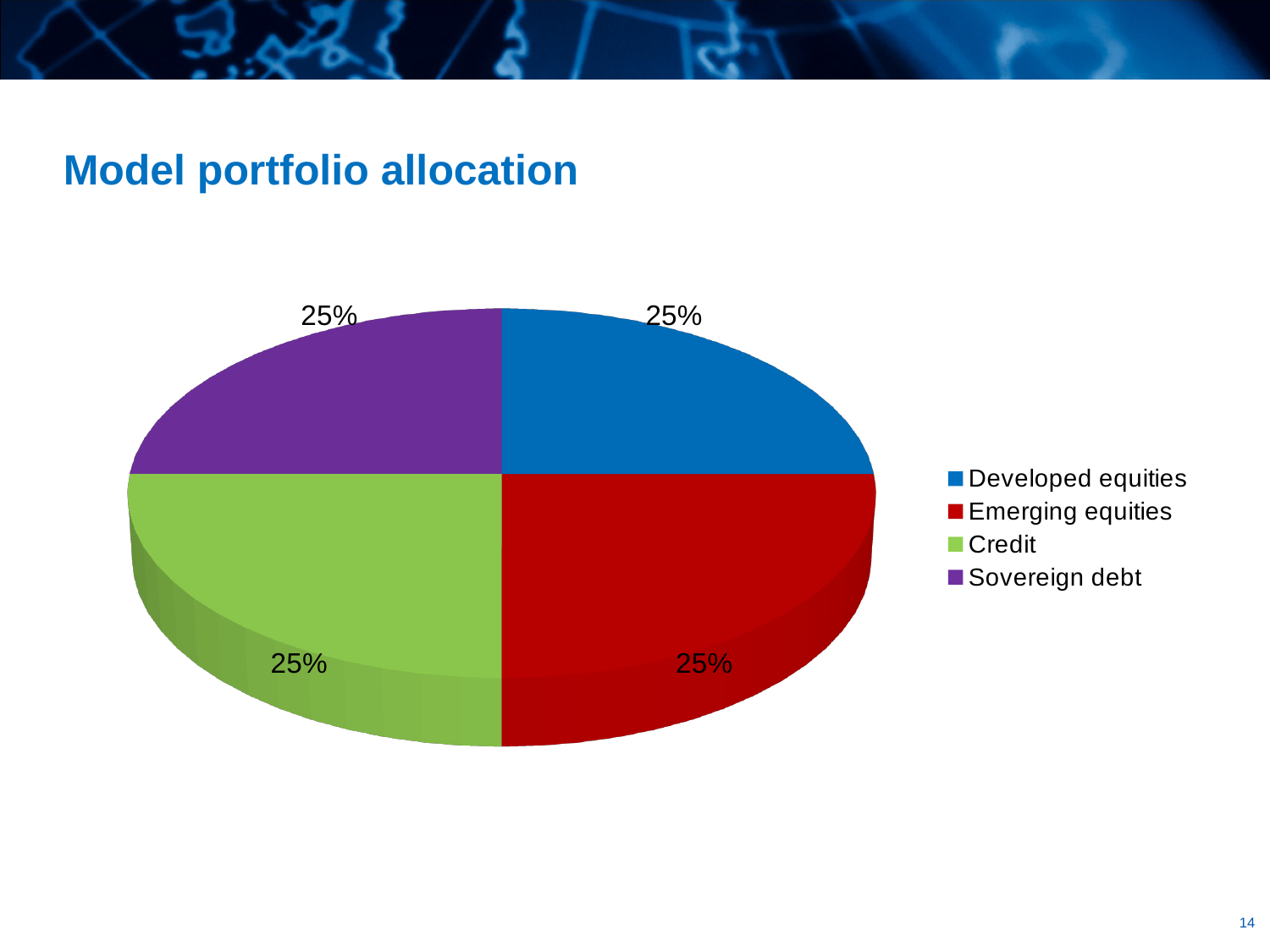
What is the combined share of Developed equities and Emerging equities? 50% Which colour represents Credit in the pie chart? green What share of the pie does Emerging equities represent? 25% How many slices does the pie chart have? 4 What share of the pie does Sovereign debt represent? 25% What kind of chart is shown on the slide? pie chart How many entries does the legend list? 4 What share of the pie does Developed equities represent? 25% What is the title of the chart? Model portfolio allocation Is the share for Emerging equities greater or less than 50%? less What is the difference between the shares for Credit and Sovereign debt? 0%